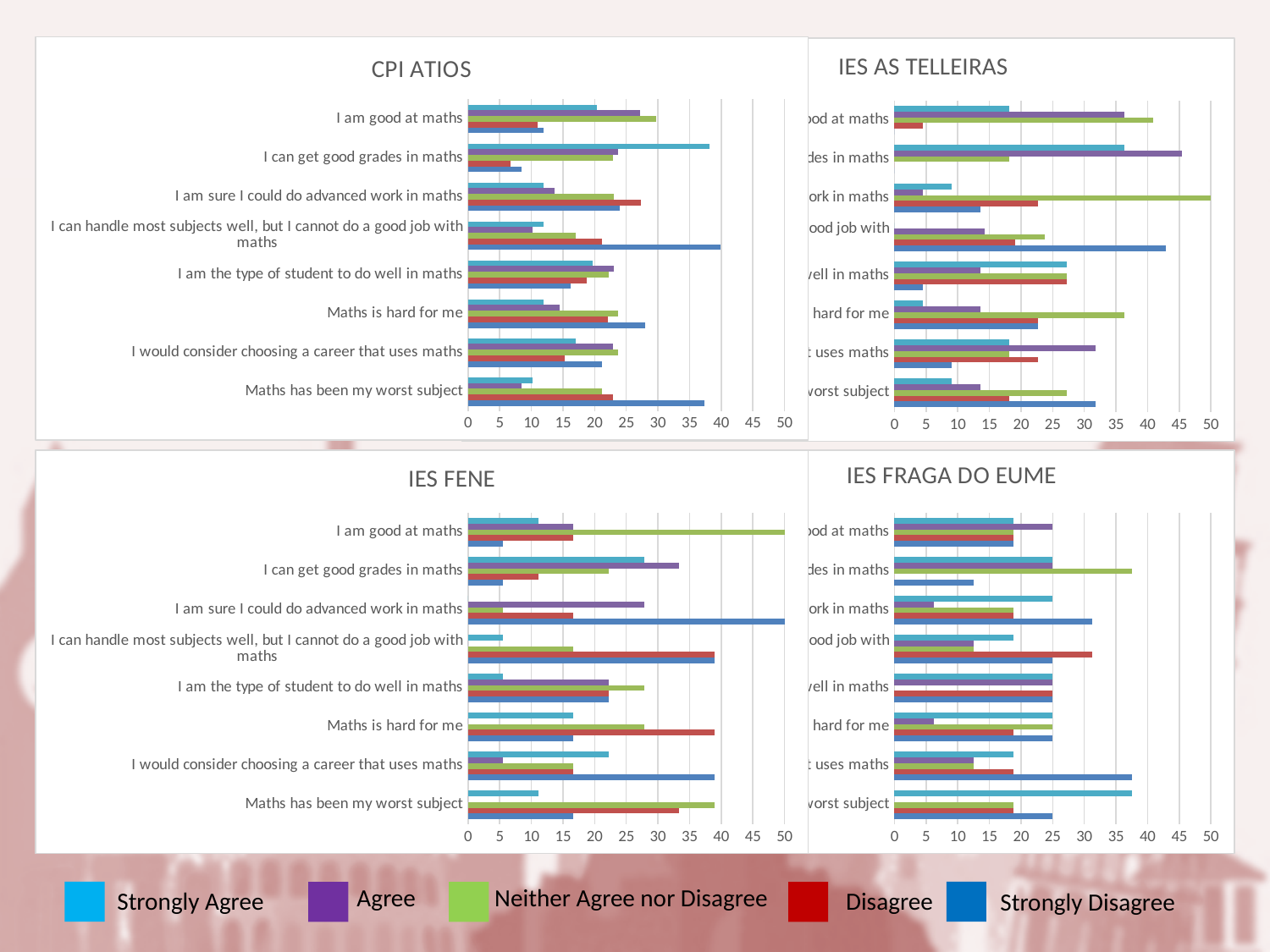
In the IES FRAGA DO EUME chart, is the Strongly Disagree value for 'I can get good grades in maths' greater or less than 15? less In the IES FENE chart, which response has the longest bar for 'I am good at maths'? Neither Agree nor Disagree How many statements (categories) are plotted in the IES FENE chart? 8 What colour represents Disagree in the legend? red In the CPI ATIOS chart, is the Strongly Disagree value for 'I can handle most subjects well, but I cannot do a good job with maths' greater or less than 35? greater In the CPI ATIOS chart, is the Strongly Agree value for 'I can get good grades in maths' greater or less than 35? greater In the IES AS TELLEIRAS chart, which response has the longest bar for 'I am sure I could do advanced work in maths'? Neither Agree nor Disagree What kind of chart is the CPI ATIOS chart? bar chart In the IES AS TELLEIRAS chart, which response has the shortest bar for 'I am good at maths'? Disagree How many series does the legend at the bottom of the slide list? 5 In the CPI ATIOS chart, for 'I am good at maths', which is larger: the Neither Agree nor Disagree value or the Disagree value? Neither Agree nor Disagree